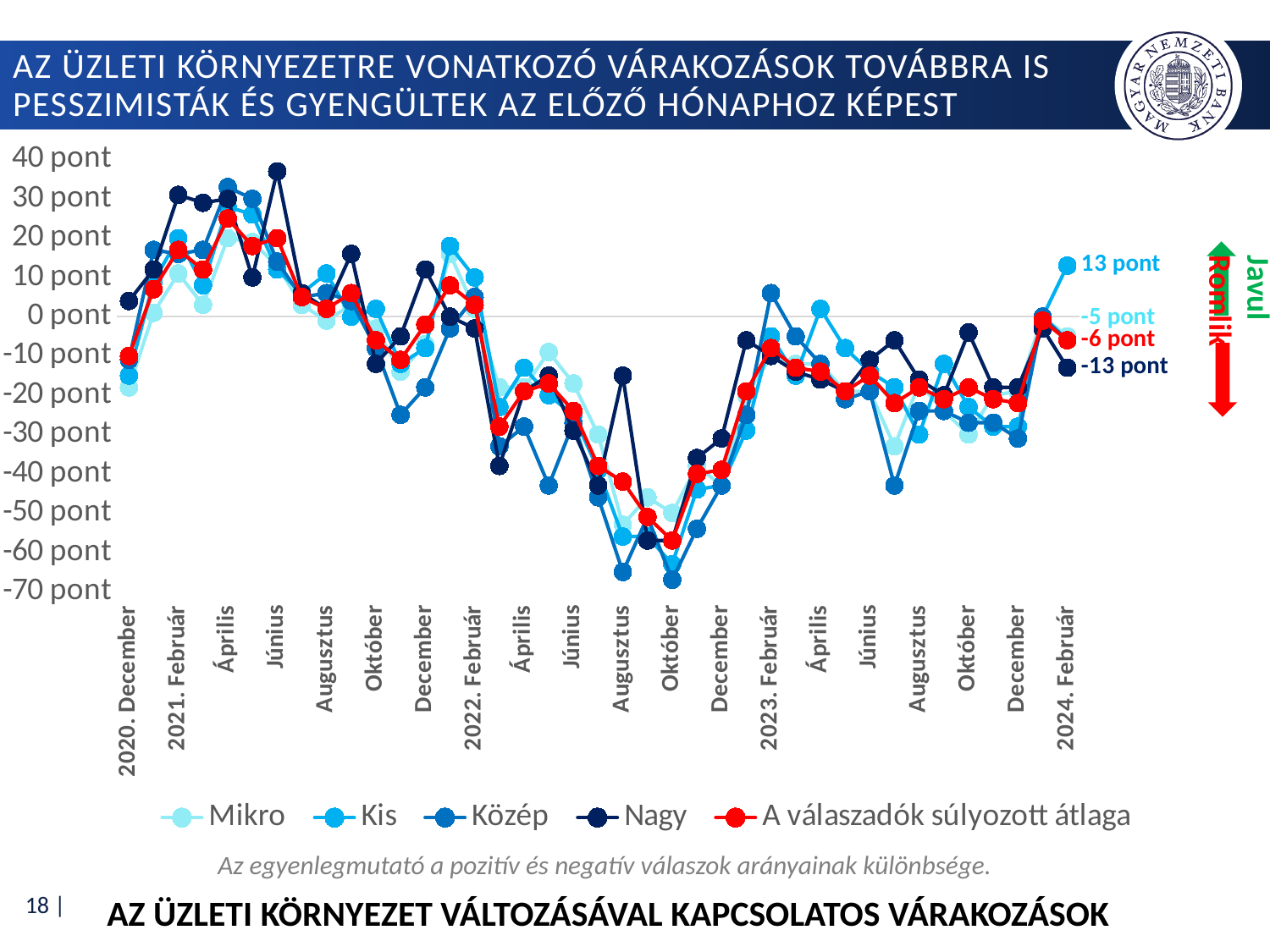
What is the value of 'A válaszadók súlyozott átlaga' at 2024. Február? -6 pont At 2024. Február, which is larger: the Kis value or the weighted average ('A válaszadók súlyozott átlaga')? Kis What is the difference between the Kis and Nagy values at 2024. Február? 26 pont How many series does the legend list? 5 What is the value of the Kis series at 2024. Február? 13 pont What is the value of the Nagy series at 2024. Február? -13 pont What is the value of the Mikro series at 2024. Február? -5 pont Which series has the highest value at 2024. Február? Kis Is the value of 'A válaszadók súlyozott átlaga' at 2022 Október greater or less than -50 pont? less What kind of chart is shown on the slide? line chart Which series has the lowest value at 2024. Február? Nagy Is the value of the Nagy series at 2021 Június greater or less than 30 pont? greater